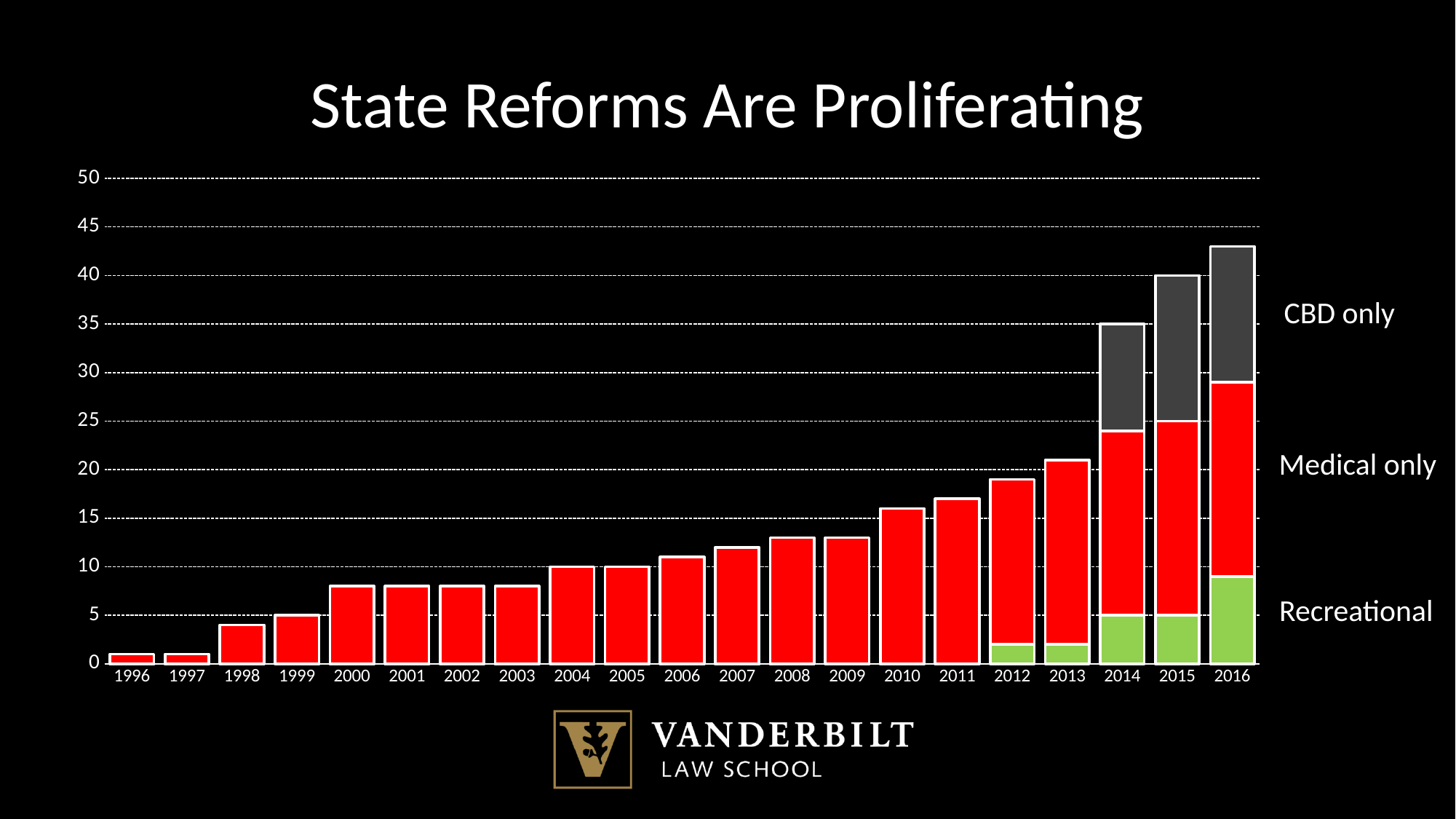
Is the total bar height for 2016 greater or less than 40? greater Do the bar totals generally rise or fall from 1996 to 2016? rise What kind of chart is shown on the slide? bar chart Is the total bar height for 2003 greater or less than 10? less How many series (segment categories) are labelled on the chart? 3 Which year has the tallest bar in the chart? 2016 What colour represents the Recreational segment in the chart? green Which year has a taller bar, 2013 or 2014? 2014 Is the total bar height for 2008 greater or less than 15? less What is the total bar height for 2015? 40 Which segment label appears at the top of the stacked bars? CBD only How many years are shown along the x axis of the chart? 21